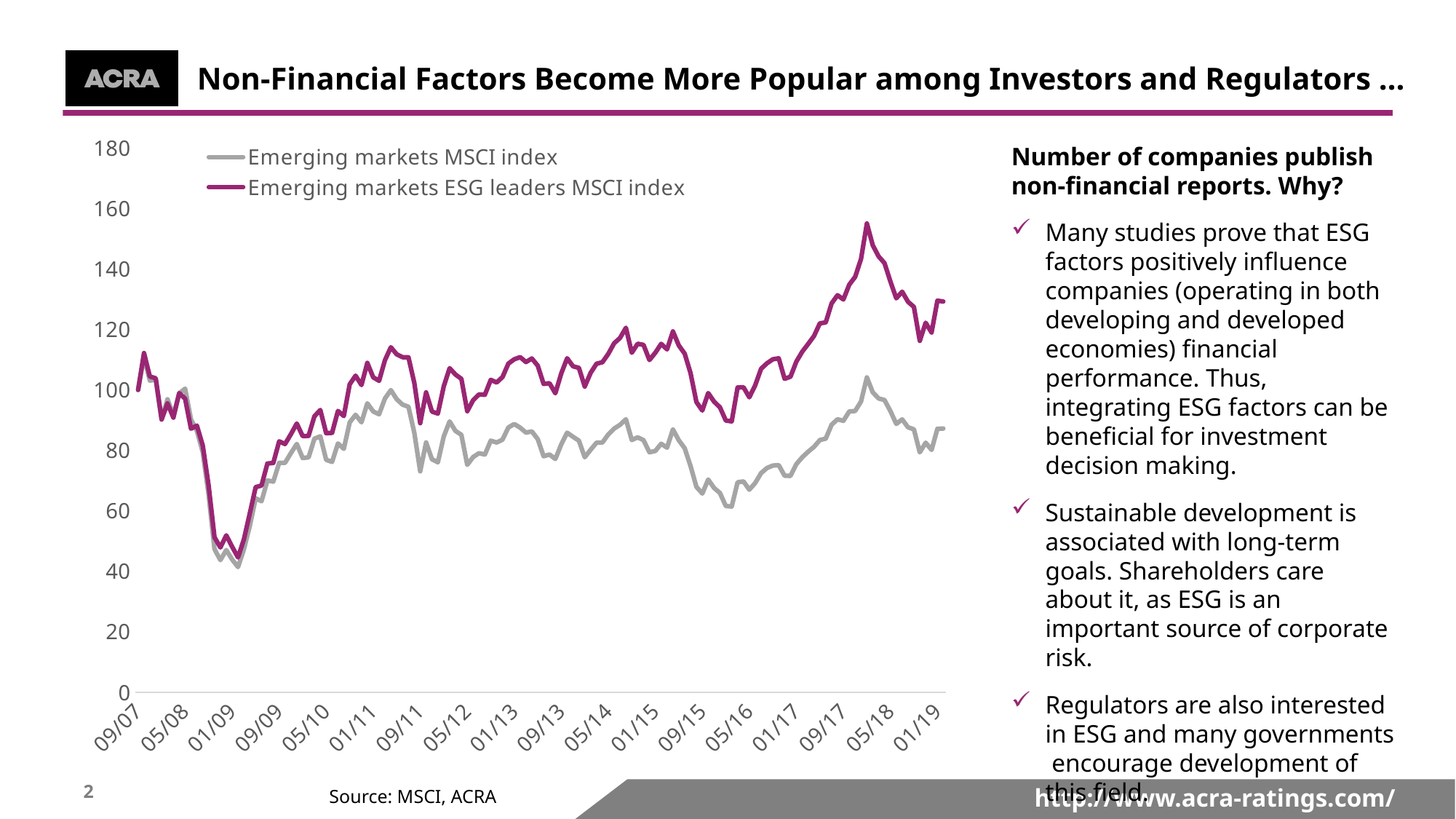
At 01/19, which series has the higher value: Emerging markets MSCI index or Emerging markets ESG leaders MSCI index? Emerging markets ESG leaders MSCI index Is the value of the Emerging markets MSCI index at 01/19 greater or less than 100? less How many series does the chart legend list? 2 Which series is drawn in purple on the chart? Emerging markets ESG leaders MSCI index What source is cited below the chart? MSCI, ACRA Is the value of the Emerging markets MSCI index at 09/15 greater or less than 80? less Which series reaches the highest value anywhere on the chart? Emerging markets ESG leaders MSCI index Is the peak value of the Emerging markets ESG leaders MSCI index around 05/18 greater or less than 140? greater What kind of chart is shown on the slide? Line chart Does the Emerging markets ESG leaders MSCI index rise or fall between 09/15 and 01/18? rise